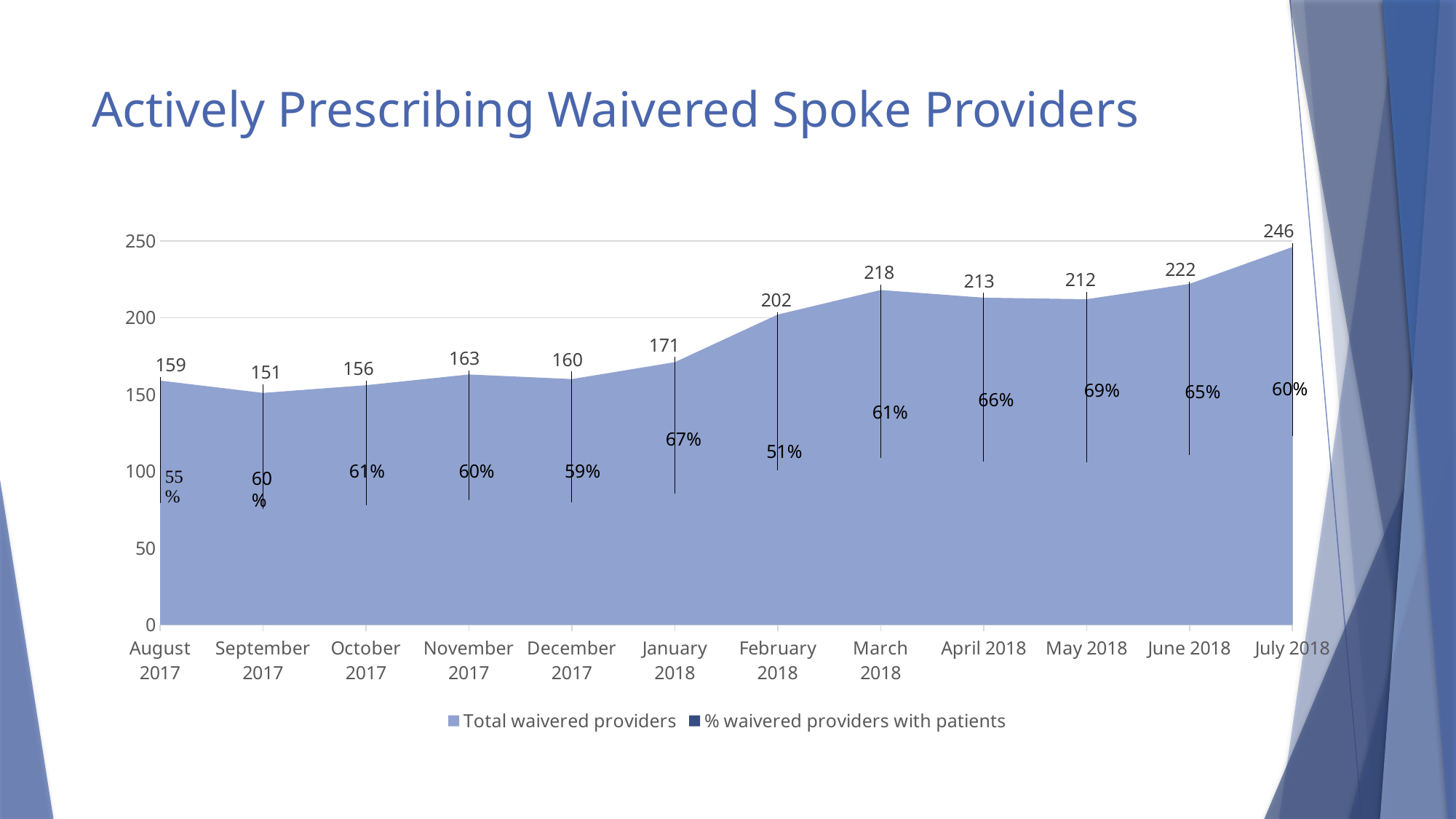
How many series does the legend list? 2 Does the total number of waivered providers generally rise or fall from August 2017 to July 2018? rise What is the title of the chart? Actively Prescribing Waivered Spoke Providers What is the difference in total waivered providers between July 2018 and August 2017? 87 What is the total number of waivered providers in February 2018? 202 What percentage of waivered providers had patients in May 2018? 69% Which is larger, the total waivered providers in April 2018 or in May 2018? April 2018 Which month has the highest total of waivered providers? July 2018 What is the total number of waivered providers in July 2018? 246 How many months are shown on the x axis? 12 Which month has the lowest total of waivered providers? September 2017 Which month has the lowest percentage of waivered providers with patients? February 2018